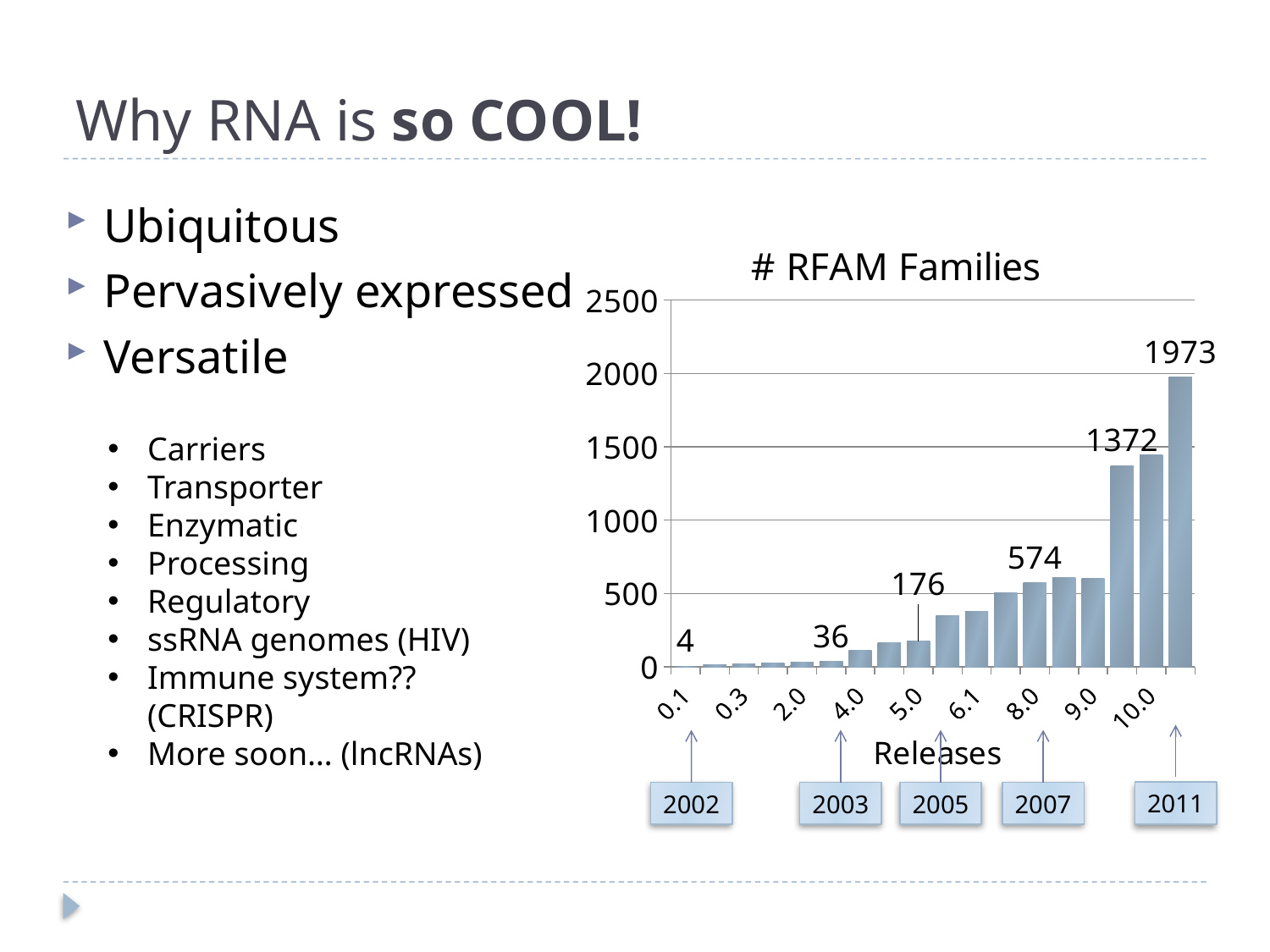
What is the difference between the values labelled 574 and 176? 398 What is the title of the chart? # RFAM Families What is the number of RFAM families for release 8.0? 574 What kind of chart is shown on the slide? bar chart What is the number of RFAM families for release 5.0? 176 Which release has the lowest number of RFAM families? 0.1 Is the value for release 6.1 greater or less than 500? less What is the number of RFAM families for release 0.1? 4 Do the values generally rise or fall from left to right across the releases? rise What is the value of the tallest bar in the chart? 1973 What is the label of the x axis of the chart? Releases